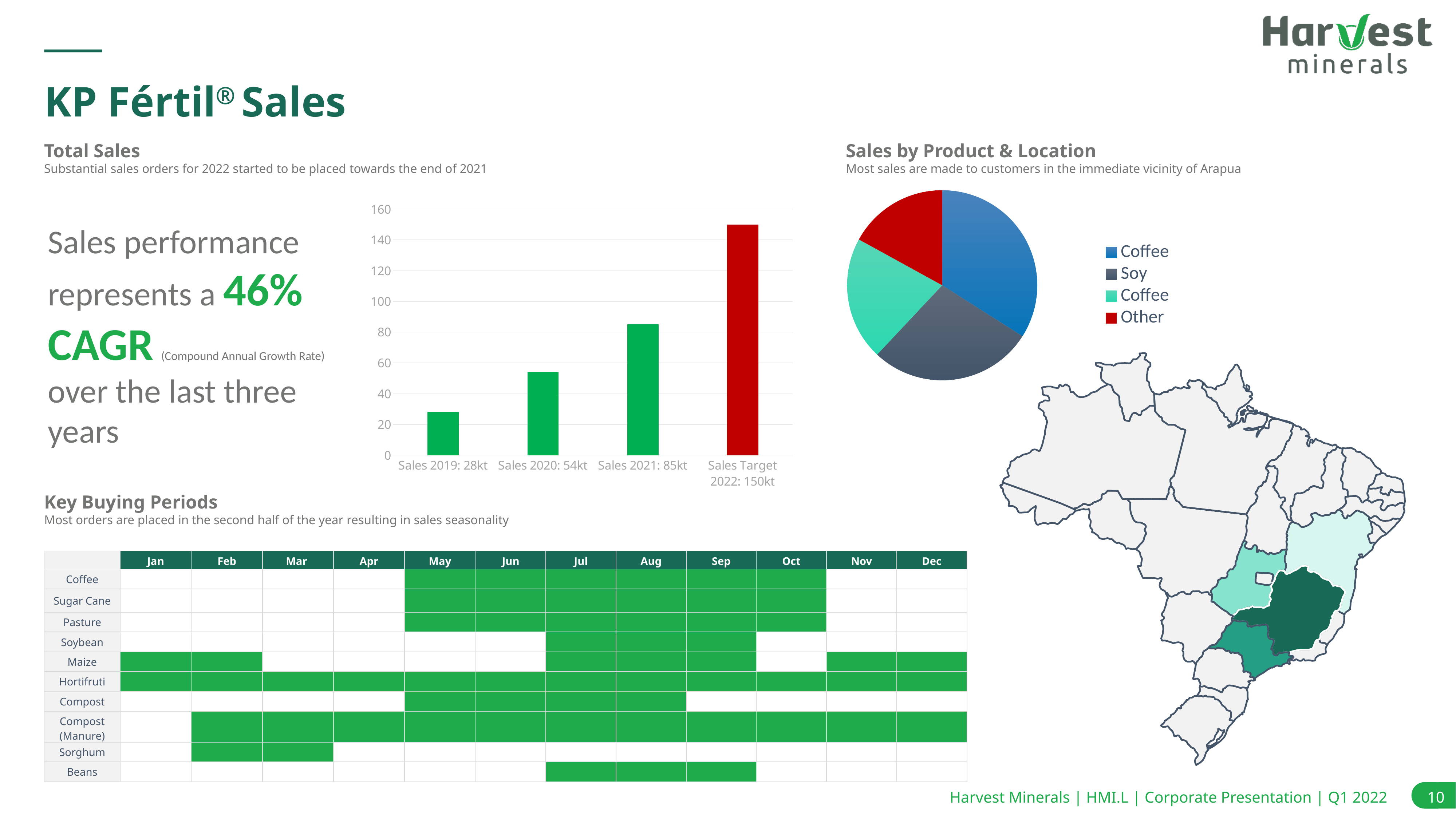
In the Total Sales chart, what is the sales target for 2022? 150kt In the Total Sales chart, what were sales in 2019? 28kt What kind of chart is the Total Sales chart? bar chart In the Total Sales chart, what colour is the Sales Target 2022 bar? red In the Total Sales chart, how much higher are 2021 sales than 2019 sales? 57kt In the Total Sales chart, how much higher is the 2022 sales target than 2021 sales? 65kt In the Total Sales chart, what were sales in 2021? 85kt How many entries does the legend of the Sales by Product & Location pie chart list? 4 How many bars are shown in the Total Sales chart? 4 In the Total Sales chart, which bar is the lowest? Sales 2019 In the Total Sales chart, which is larger: sales in 2020 or sales in 2021? Sales 2021 In the Total Sales chart, do the values rise or fall from left to right? rise